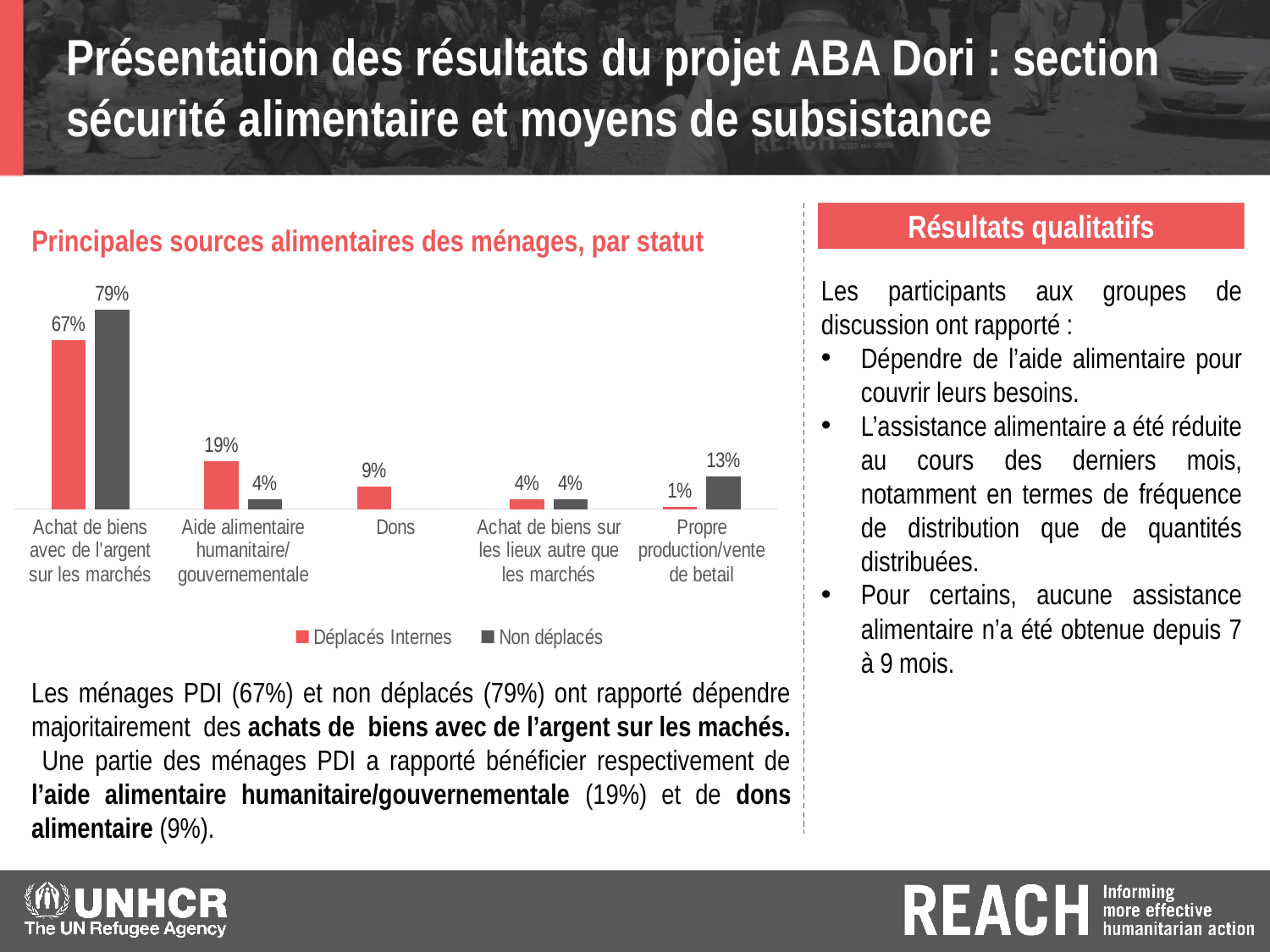
How many categories are shown on the x axis of the chart? 5 What is the difference between the Non déplacés and Déplacés Internes values for 'Achat de biens avec de l'argent sur les marchés'? 12% Which category has the highest value for Non déplacés? Achat de biens avec de l'argent sur les marchés What is the value for Déplacés Internes for 'Dons'? 9% For 'Aide alimentaire humanitaire/gouvernementale', which series has the larger value, Déplacés Internes or Non déplacés? Déplacés Internes How many series does the legend list? 2 Which category has the lowest value for Déplacés Internes? Propre production/vente de betail What is the value for Non déplacés for 'Propre production/vente de betail'? 13% What type of chart is shown on the slide? bar chart What is the value for Non déplacés for 'Achat de biens avec de l'argent sur les marchés'? 79% What is the value for Déplacés Internes for 'Aide alimentaire humanitaire/gouvernementale'? 19% What is the value for Déplacés Internes for 'Achat de biens avec de l'argent sur les marchés'? 67%